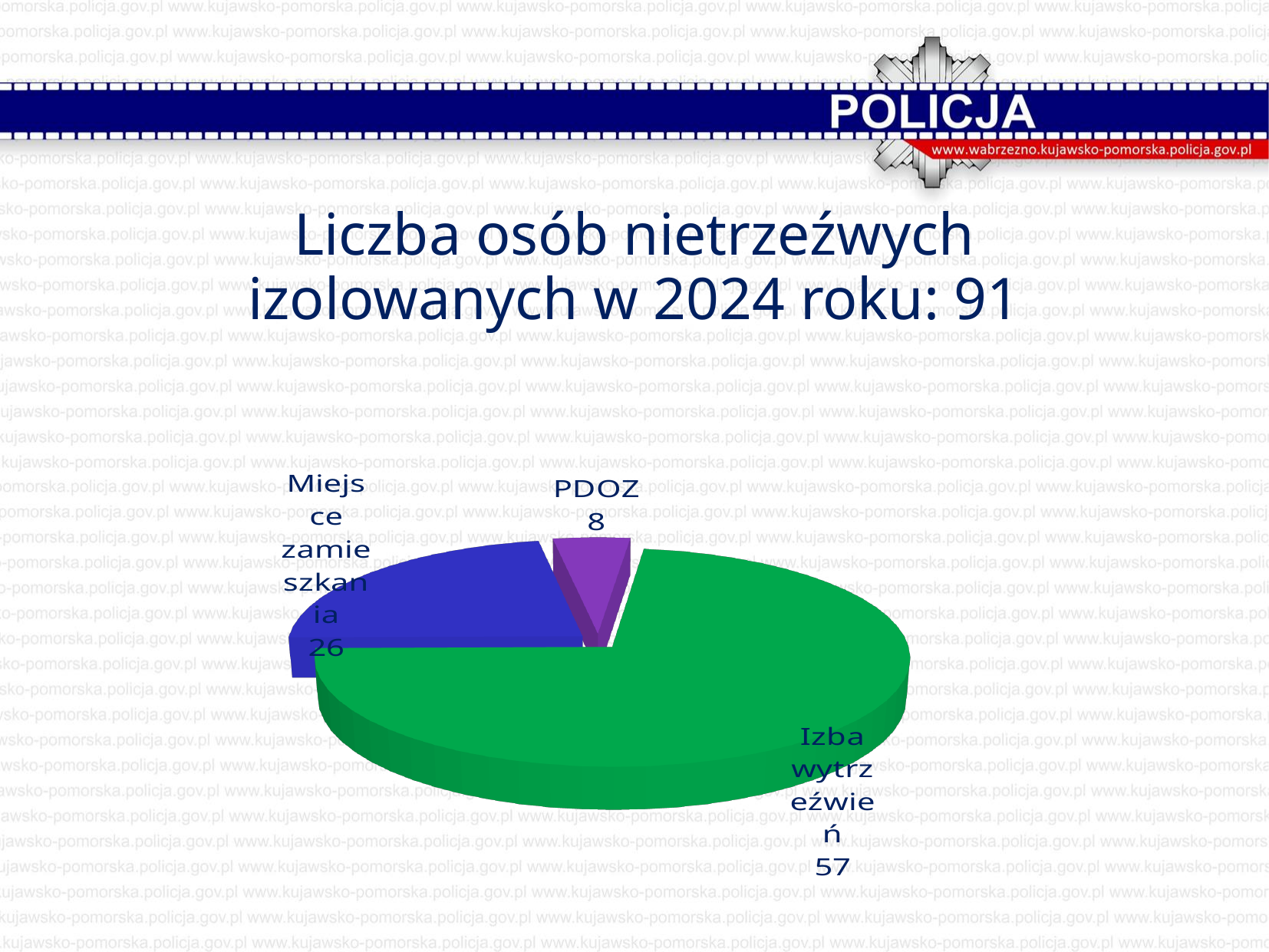
What is the value for PDOZ? 8 What is the difference between the values for Miejsce zamieszkania and PDOZ? 18 What is the value for Izba wytrzeźwień? 57 Which category has the smallest slice? PDOZ What type of chart is shown on the slide? pie chart What is the value for Miejsce zamieszkania? 26 Which category has the largest slice? Izba wytrzeźwień What colour is the slice for Izba wytrzeźwień? green What is the total of all slices in the pie chart? 91 How many slices does the pie chart have? 3 What is the difference between the values for Izba wytrzeźwień and Miejsce zamieszkania? 31 Which is larger, the value for Miejsce zamieszkania or the value for PDOZ? Miejsce zamieszkania